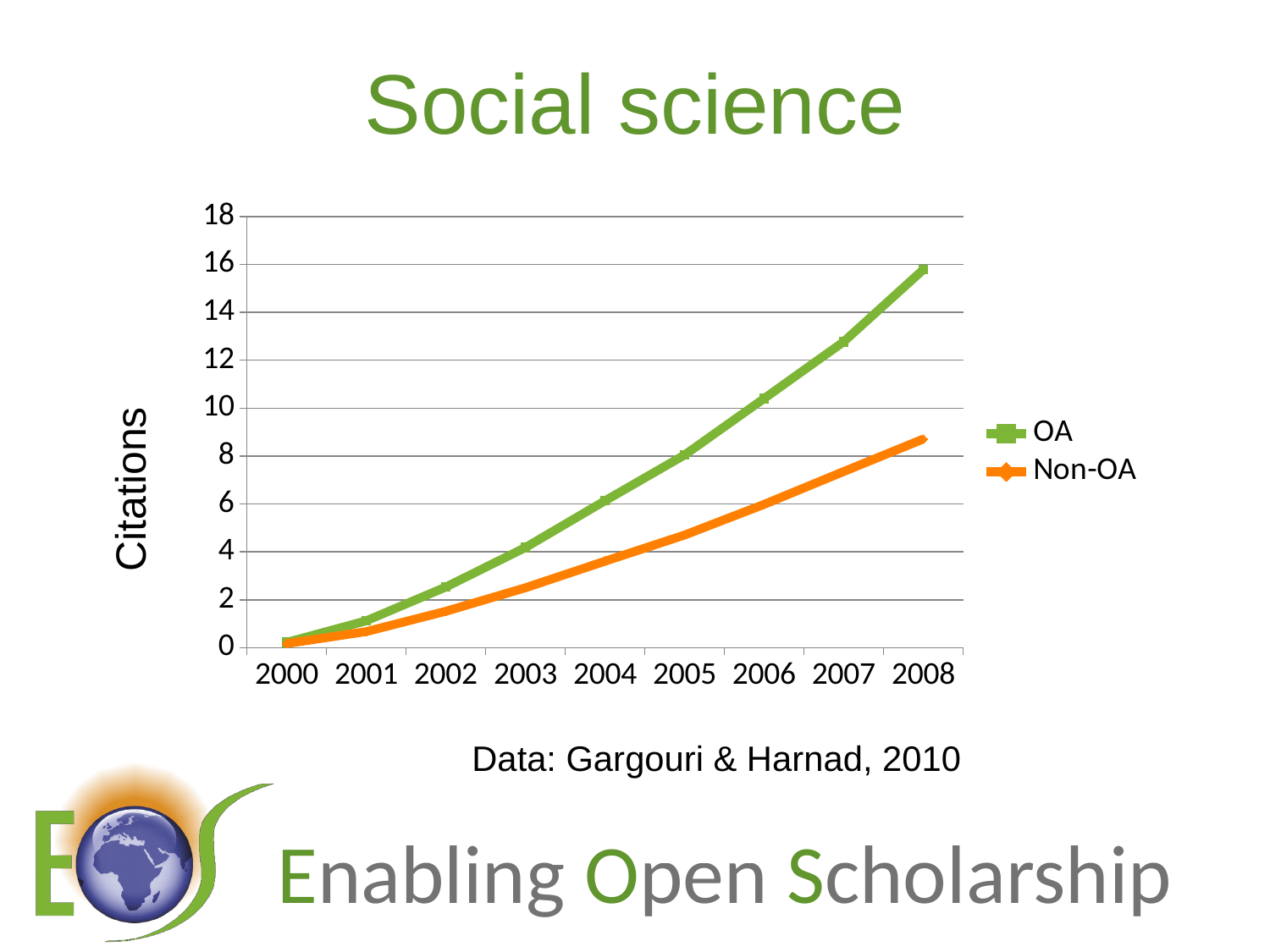
Is the value for OA in 2007 greater or less than 12? greater What is the label on the y axis? Citations How many years are shown on the x axis? 9 Is the value for OA in 2008 greater or less than 14? greater Which series has the higher value in 2008, OA or Non-OA? OA In which year is the Non-OA series at its lowest value? 2000 In which year does the OA series reach its highest value? 2008 Do the OA citations rise or fall from 2000 to 2008? rise Is the value for Non-OA in 2005 greater or less than 6? less How many series does the legend list? 2 What type of chart is shown on the slide? line chart